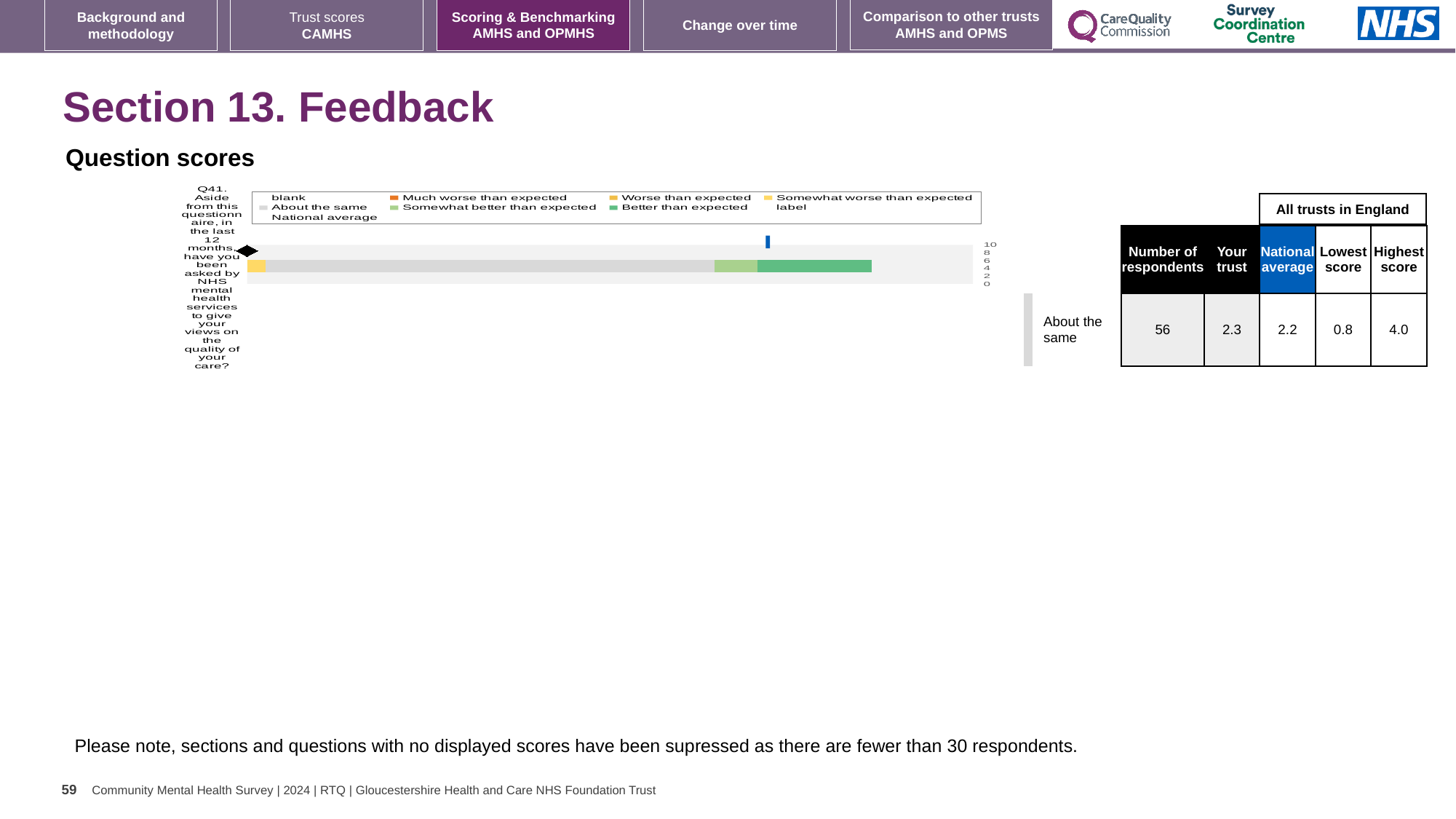
How many entries does the legend of the Question scores chart list? 9 How many question categories are plotted in the Question scores chart? 1 In the table beside the chart, what is the number of respondents for Q41? 56 In the table beside the chart, which is larger for Q41: the 'Your trust' score or the national average? Your trust What colour does the legend use for 'Better than expected' in the Question scores chart? green In the table beside the chart, what is the difference between the highest score and the lowest score for Q41? 3.2 What kind of chart is shown under 'Question scores'? bar chart In the table beside the chart, what is the lowest score among all trusts in England for Q41? 0.8 Which question number is plotted in the Question scores chart? Q41 In the table beside the chart, what is the 'Your trust' score for Q41? 2.3 In the table beside the chart, what is the highest score among all trusts in England for Q41? 4.0 In the table beside the chart, what is the national average score for Q41? 2.2